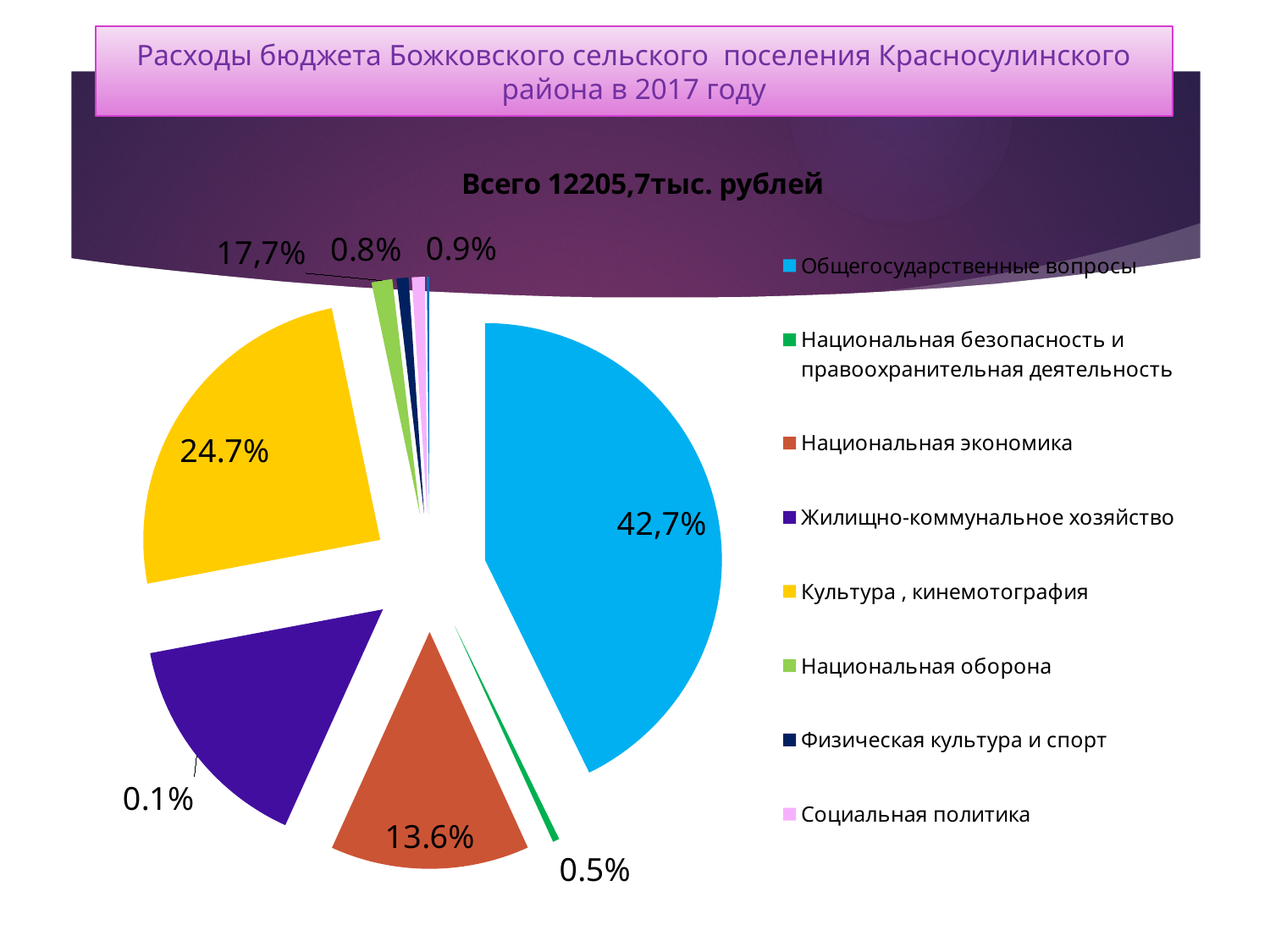
What share of the pie does Национальная безопасность и правоохранительная деятельность have? 0.5% What is the title of the chart on the slide? Всего 12205,7тыс. рублей What share of the pie does Общегосударственные вопросы have? 42,7% What is the difference between the share for Культура, кинемотография and the share for Национальная экономика? 11.1% What share of the pie does Культура, кинемотография have? 24.7% How many categories does the legend of the pie chart list? 8 Which is larger: the share for Общегосударственные вопросы or the share for Культура, кинемотография? Общегосударственные вопросы What kind of chart is shown on the slide? pie chart What total amount of expenditure is stated above the pie chart? 12205,7 тыс. рублей Which category has the largest slice of the pie? Общегосударственные вопросы Which is larger: the share for Культура, кинемотография or the share for Национальная экономика? Культура, кинемотография